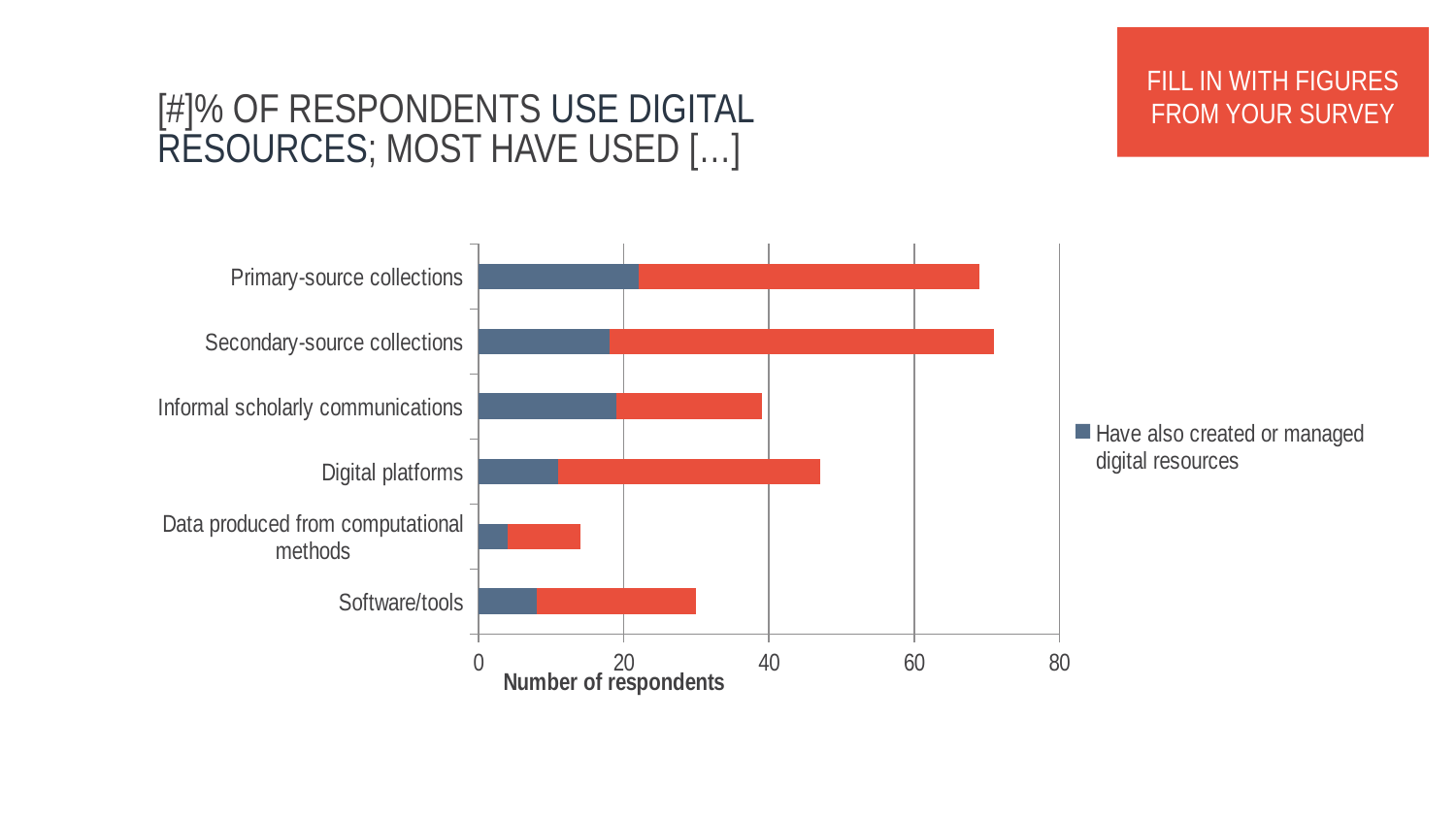
Is the total value for Data produced from computational methods greater or less than 20? less Is the total value for Primary-source collections greater or less than 60? greater Is the total value for Software/tools greater or less than 20? greater Which category has the lowest total number of respondents? Data produced from computational methods What kind of chart is shown on the slide? Stacked bar chart How many categories are plotted on the chart? 6 What is the legend entry shown on the chart? Have also created or managed digital resources How many series does the chart's legend list? 1 Which has a larger total number of respondents, Digital platforms or Informal scholarly communications? Digital platforms What is the title of the horizontal axis? Number of respondents